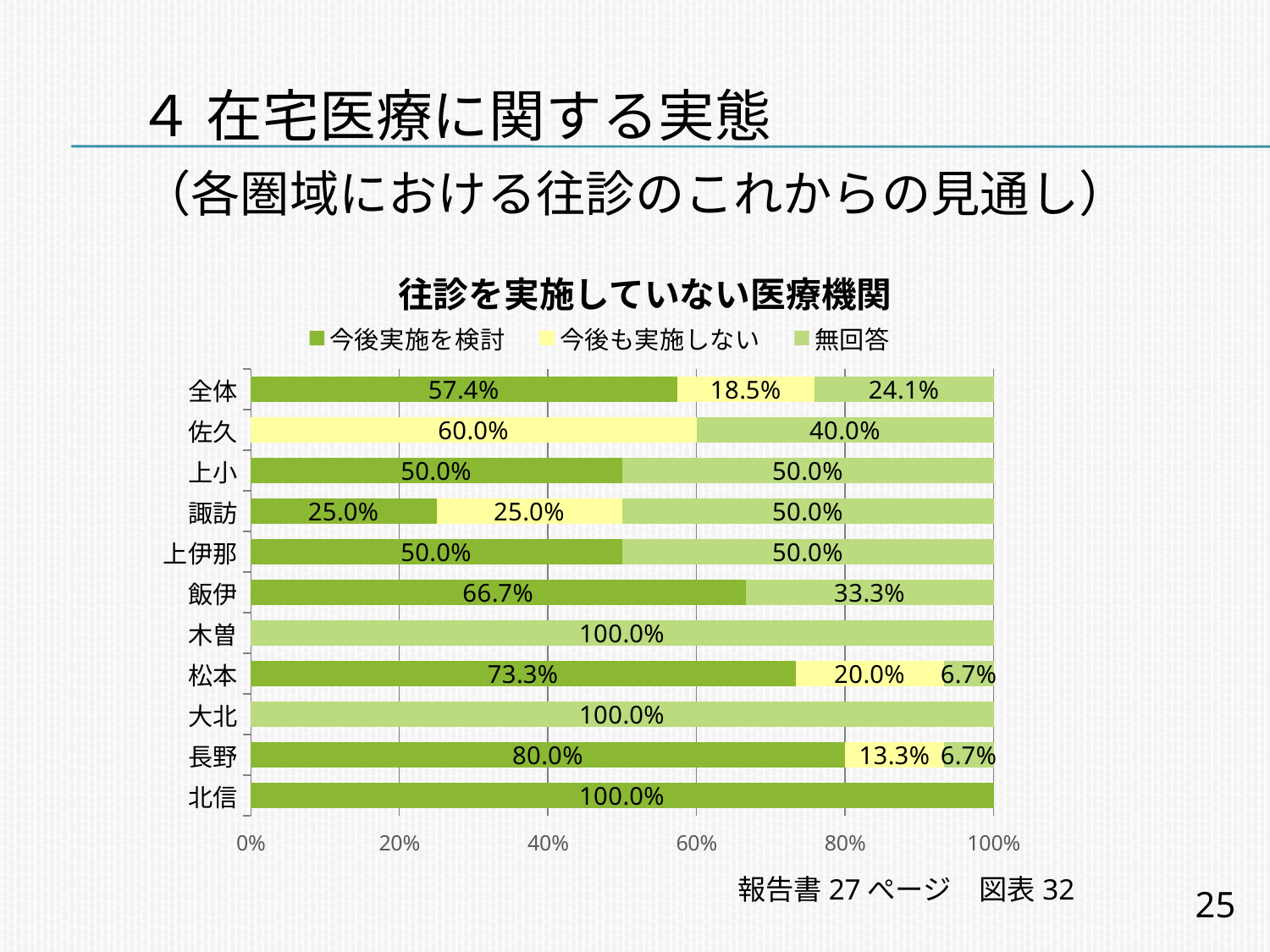
Which region has the highest value for 今後も実施しない? 佐久 How many series does the legend list? 3 What is the total of the 今後実施を検討 and 今後も実施しない values for 諏訪? 50.0% What is the value of 今後も実施しない for 佐久? 60.0% What is the value of 無回答 for 松本? 6.7% What is the title of the chart? 往診を実施していない医療機関 Which region has the highest value for 今後実施を検討? 北信 How many categories (regions) are shown on the vertical axis? 11 Which is larger, the 今後実施を検討 value for 飯伊 or for 上伊那? 飯伊 What type of chart is shown on the slide? stacked bar chart What is the difference between the 今後実施を検討 values for 長野 and 松本? 6.7 percentage points What is the value of 今後実施を検討 for 全体? 57.4%